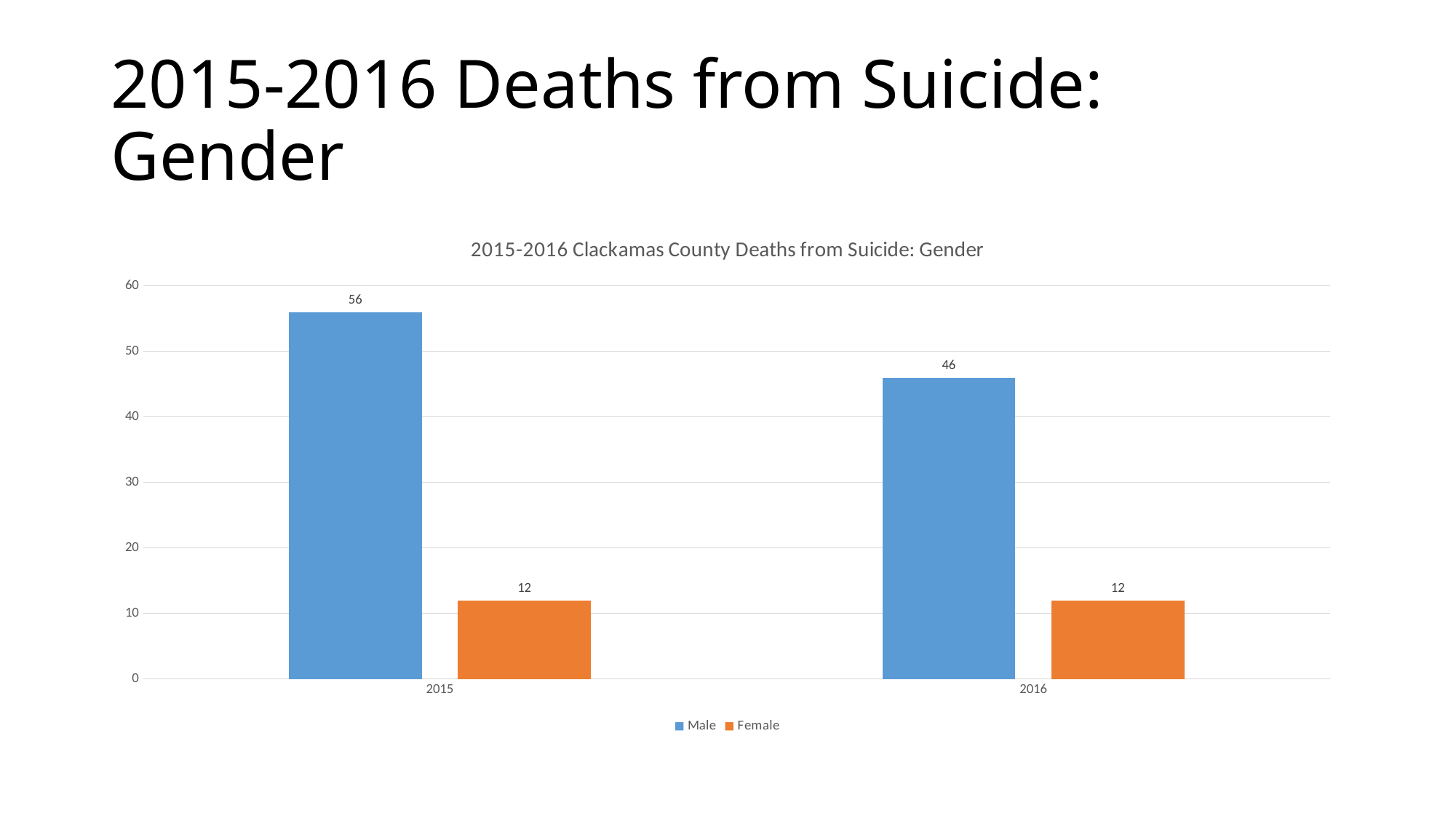
Which year has the highest Male value? 2015 What is the difference between the Male and Female values in 2015? 44 What is the value for Male in 2015? 56 How many series does the legend list? 2 Is the Male value for 2016 greater or less than 40? greater Does the Male value rise or fall from 2015 to 2016? fall What is the value for Female in 2016? 12 Which is larger in 2016, the Male value or the Female value? Male What kind of chart is shown on the slide? bar chart What is the difference between the Male values for 2015 and 2016? 10 How many years are shown on the x axis? 2 What is the value for Male in 2016? 46